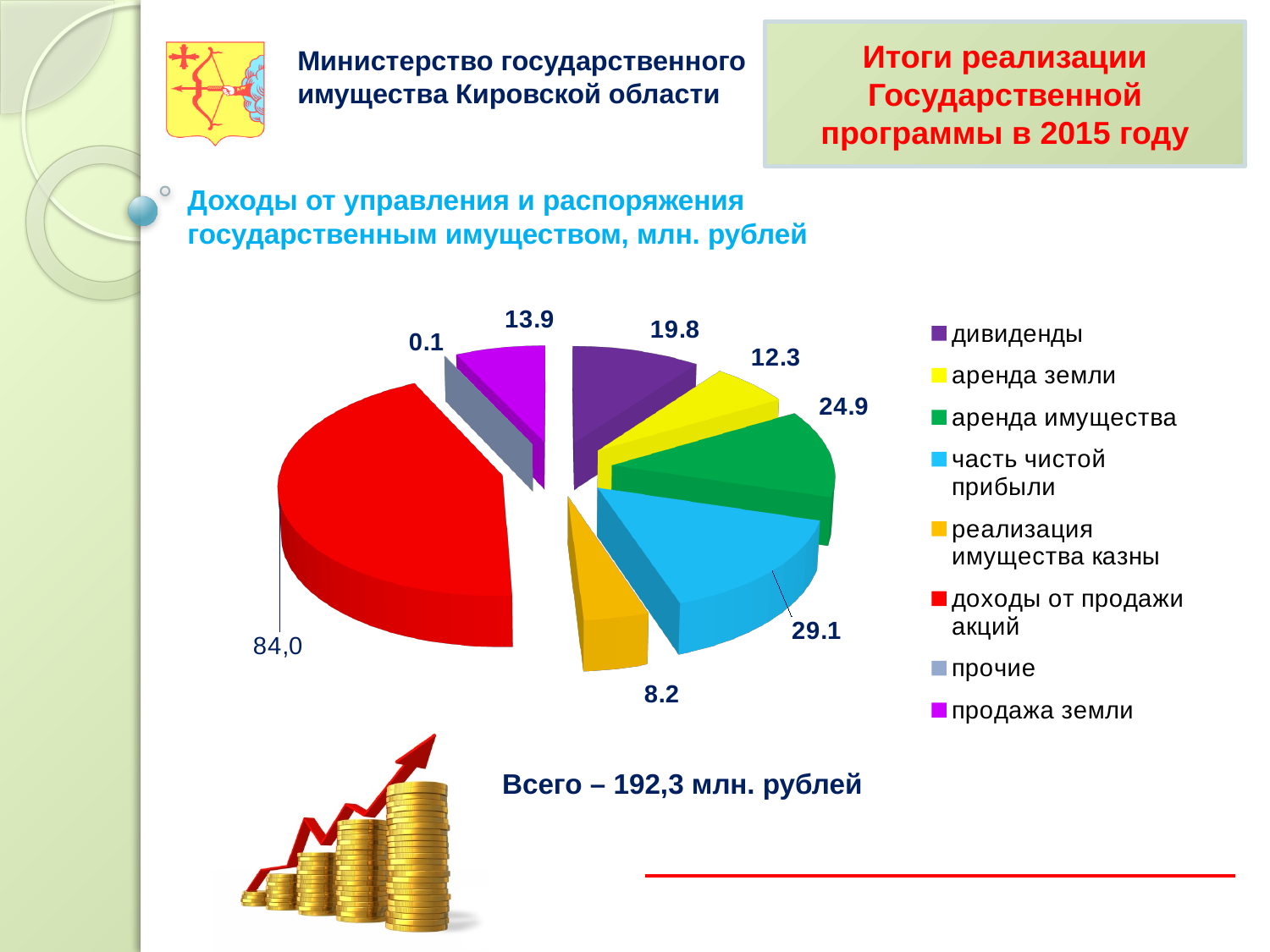
What is the value for "часть чистой прибыли" in the pie chart? 29.1 What total is stated below the pie chart? 192,3 млн. рублей What is the value for "аренда имущества" in the pie chart? 24.9 Which category has the largest slice in the pie chart? доходы от продажи акций What colour is the slice for "часть чистой прибыли"? blue Which category has the smallest slice in the pie chart? прочие What is the difference between the values for "дивиденды" and "аренда земли"? 7.5 Which is larger: "продажа земли" or "аренда земли"? продажа земли What type of chart is shown on the slide? pie chart How many categories does the legend of the pie chart list? 8 What is the value for "реализация имущества казны" in the pie chart? 8.2 What is the value for "доходы от продажи акций" in the pie chart? 84,0